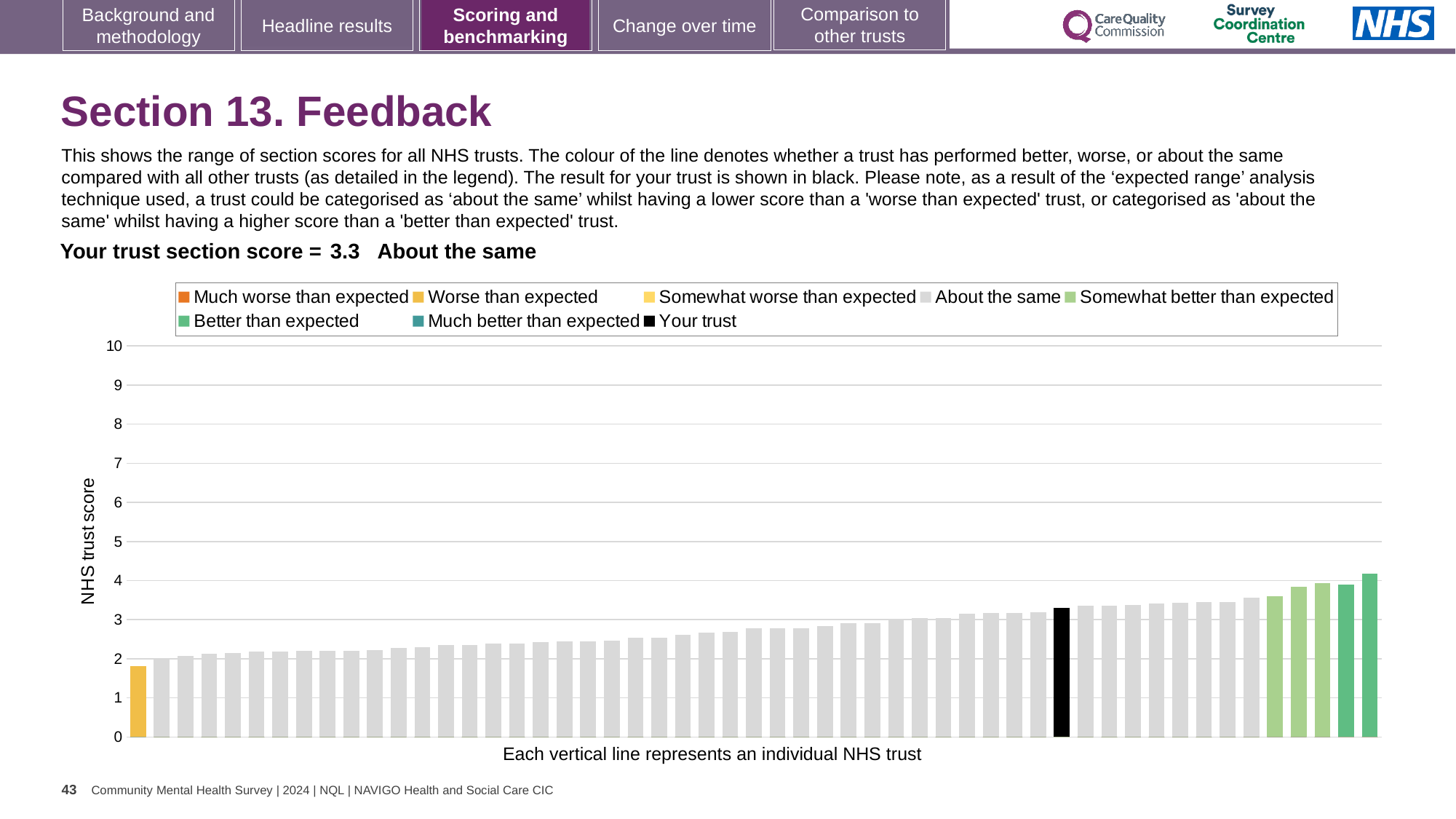
How many entries does the chart legend list? 8 Is the value of the lowest bar greater or less than 1? greater Is the value of the black bar (your trust) greater or less than 3? greater What is the label on the vertical axis of the chart? NHS trust score Which legend category does the highest bar on the chart belong to? Better than expected What is the section score for your trust shown on the slide? 3.3 What kind of chart is shown on the slide? bar chart Is the value of the lowest bar (the yellow bar on the far left) greater or less than 2? less Which performance category is your trust placed in for Section 13? About the same How many bars are coloured as 'Worse than expected' (yellow)? 1 Do the bar values rise or fall from left to right along the x axis? rise